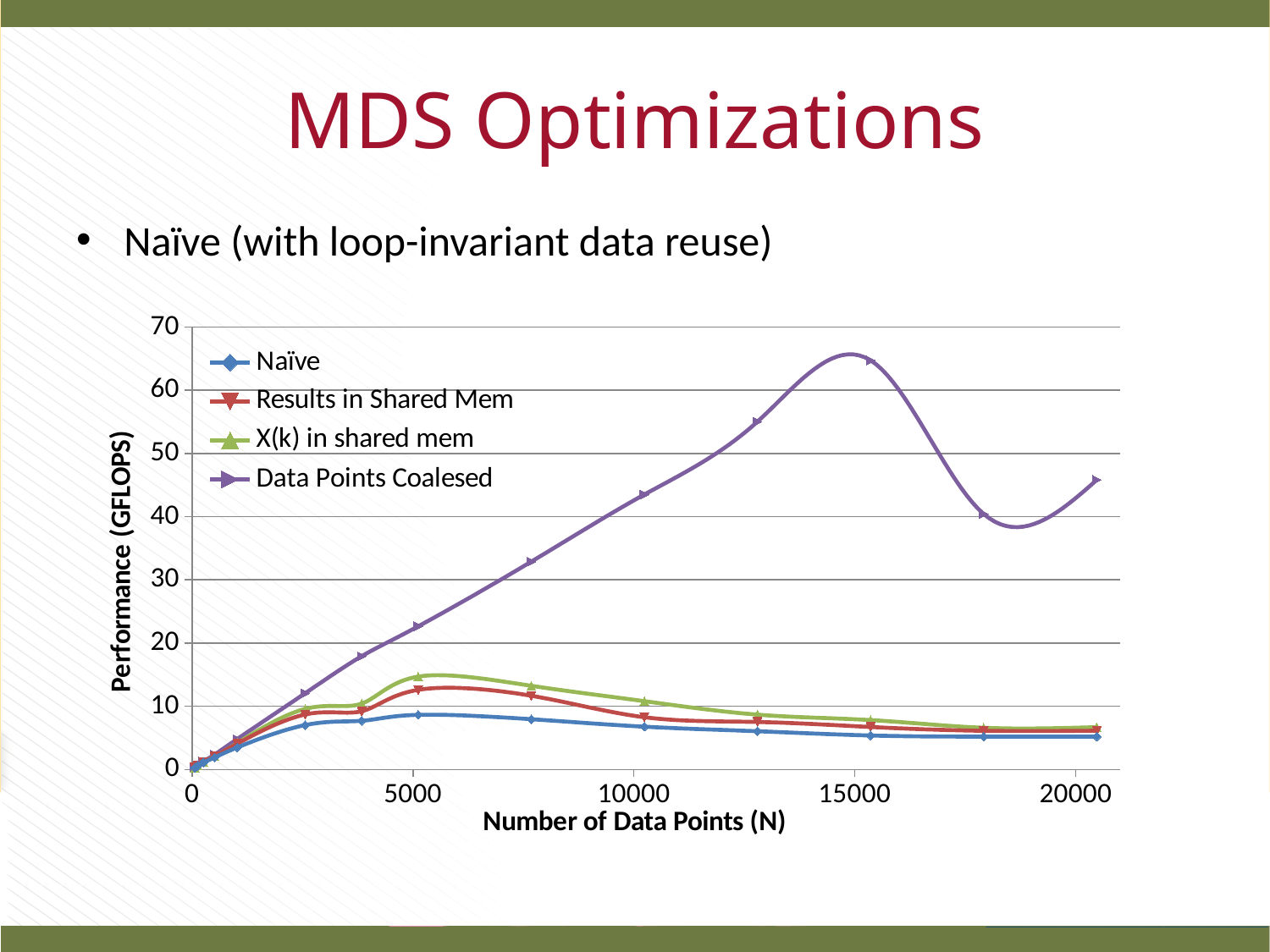
Is the value for Data Points Coalesed at 15000 data points greater or less than 60? greater What is the label of the x axis? Number of Data Points (N) Which series has the lowest performance values across the chart? Naïve Is the value for Data Points Coalesed at 10000 data points greater or less than 40? greater Does the Data Points Coalesed series rise or fall between 15000 and 18000 data points? fall Is the value for X(k) in shared mem at 5000 data points greater or less than 10? greater At 10000 data points, which is larger: Data Points Coalesed or Naïve? Data Points Coalesed What is the label of the y axis? Performance (GFLOPS) Which series reaches the highest performance value on the chart? Data Points Coalesed What kind of chart is shown on the slide? line chart How many series does the legend list? 4